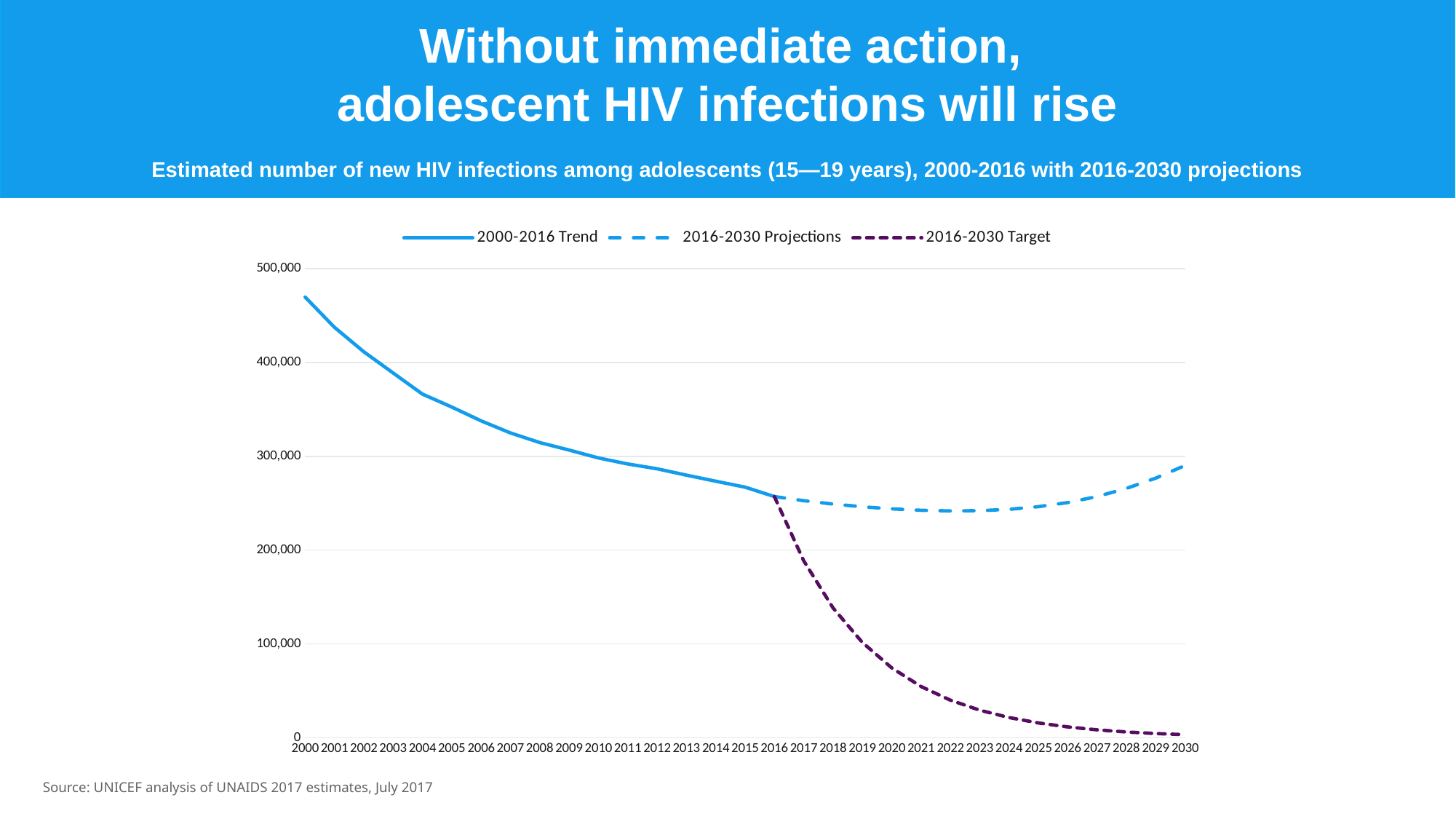
Is the 2000-2016 Trend value for 2000 greater or less than 400,000? greater Which year has the highest value on the 2000-2016 Trend line? 2000 Is the 2016-2030 Target value for 2030 greater or less than 100,000? less What are the three series named in the legend? 2000-2016 Trend, 2016-2030 Projections, 2016-2030 Target Does the 2016-2030 Target line rise or fall from 2016 to 2030? Fall How many series does the legend list? 3 Is the 2000-2016 Trend value for 2016 greater or less than 300,000? less In 2030, which is larger: the 2016-2030 Projections value or the 2016-2030 Target value? 2016-2030 Projections Does the 2000-2016 Trend line rise or fall from 2000 to 2016? Fall What kind of chart is shown on the slide? Line chart How many years are labelled on the x axis? 31